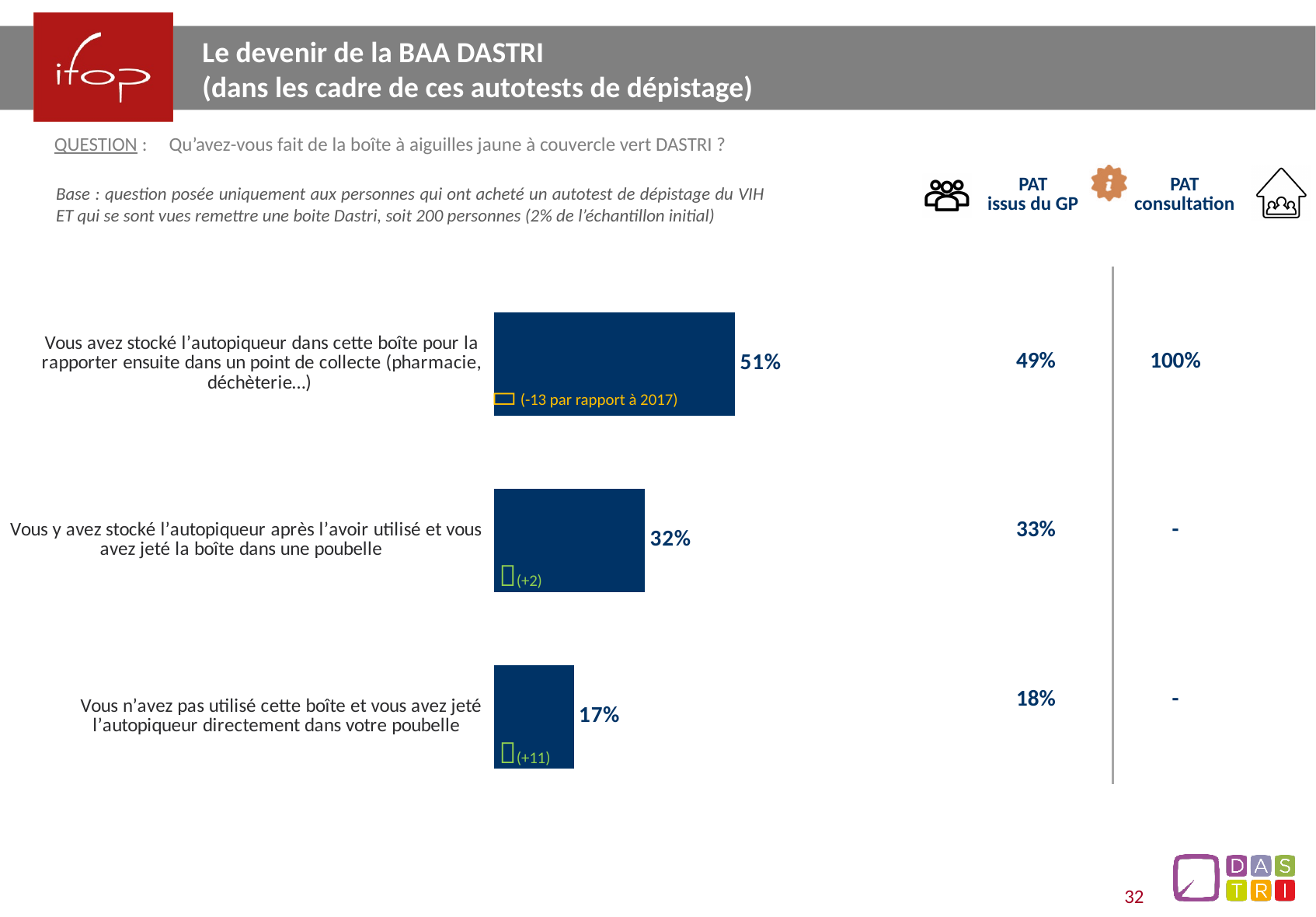
How many response categories are shown in the bar chart? 3 Which response has the lowest percentage in the bar chart? Vous n'avez pas utilisé cette boîte et vous avez jeté l'autopiqueur directement dans votre poubelle In the 'PAT consultation' column, what percentage stored the lancet in the box to bring it to a collection point? 100% Which is larger: the overall percentage for throwing the lancet directly in the bin (17%) or the 'PAT issus du GP' percentage for the same response (18%)? PAT issus du GP (18%) What is the difference in percentage points between the highest response (51%) and the lowest response (17%)? 34 points What percentage of respondents stored the lancet in the box to bring it to a collection point (pharmacy, waste centre...)? 51% Which response has the highest percentage in the bar chart? Vous avez stocké l'autopiqueur dans cette boîte pour la rapporter ensuite dans un point de collecte (pharmacie, déchèterie…) What type of chart is used on this slide? Bar chart What percentage of respondents did not use the box and threw the lancet directly in their bin? 17% What is the change compared to 2017 shown for the response about bringing the box to a collection point? -13 What percentage of respondents stored the lancet in the box after use and then threw the box in a bin? 32% In the 'PAT issus du GP' column, what percentage stored the lancet in the box after use and threw the box in a bin? 33%